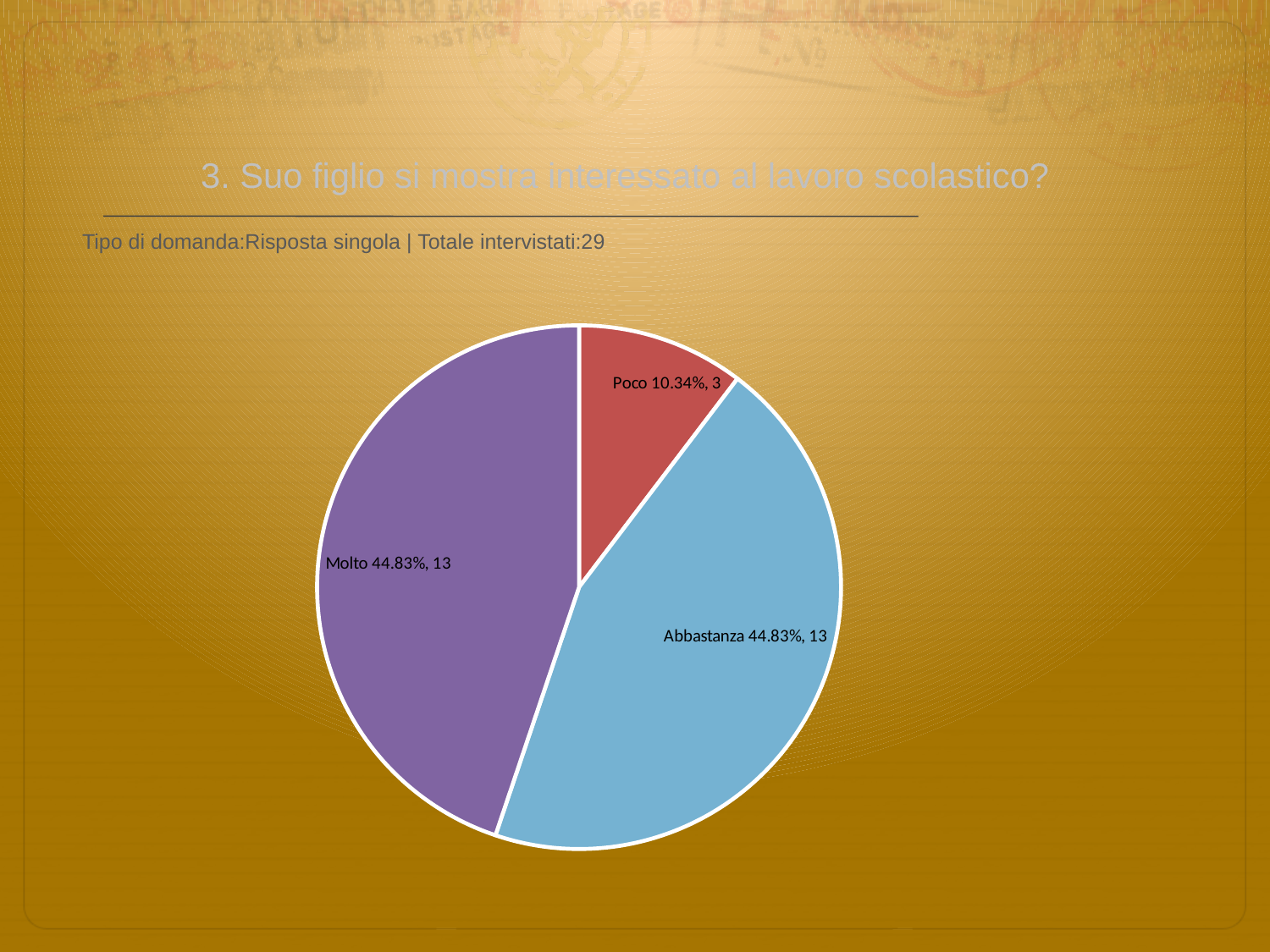
Which is larger, the count for "Poco" or the count for "Abbastanza"? Abbastanza How many respondents chose "Poco"? 3 What is the title of the chart's question on the slide? 3. Suo figlio si mostra interessato al lavoro scolastico? Which category has the smallest slice of the pie? Poco What share of the pie does the "Poco" slice represent? 10.34% What share of the pie does the "Molto" slice represent? 44.83% How many slices does the pie chart have? 3 How many respondents chose "Abbastanza"? 13 What colour is the "Poco" slice of the pie? red What kind of chart is shown on the slide? pie chart How many respondents chose "Molto"? 13 What is the difference between the number of respondents for "Molto" and for "Poco"? 10